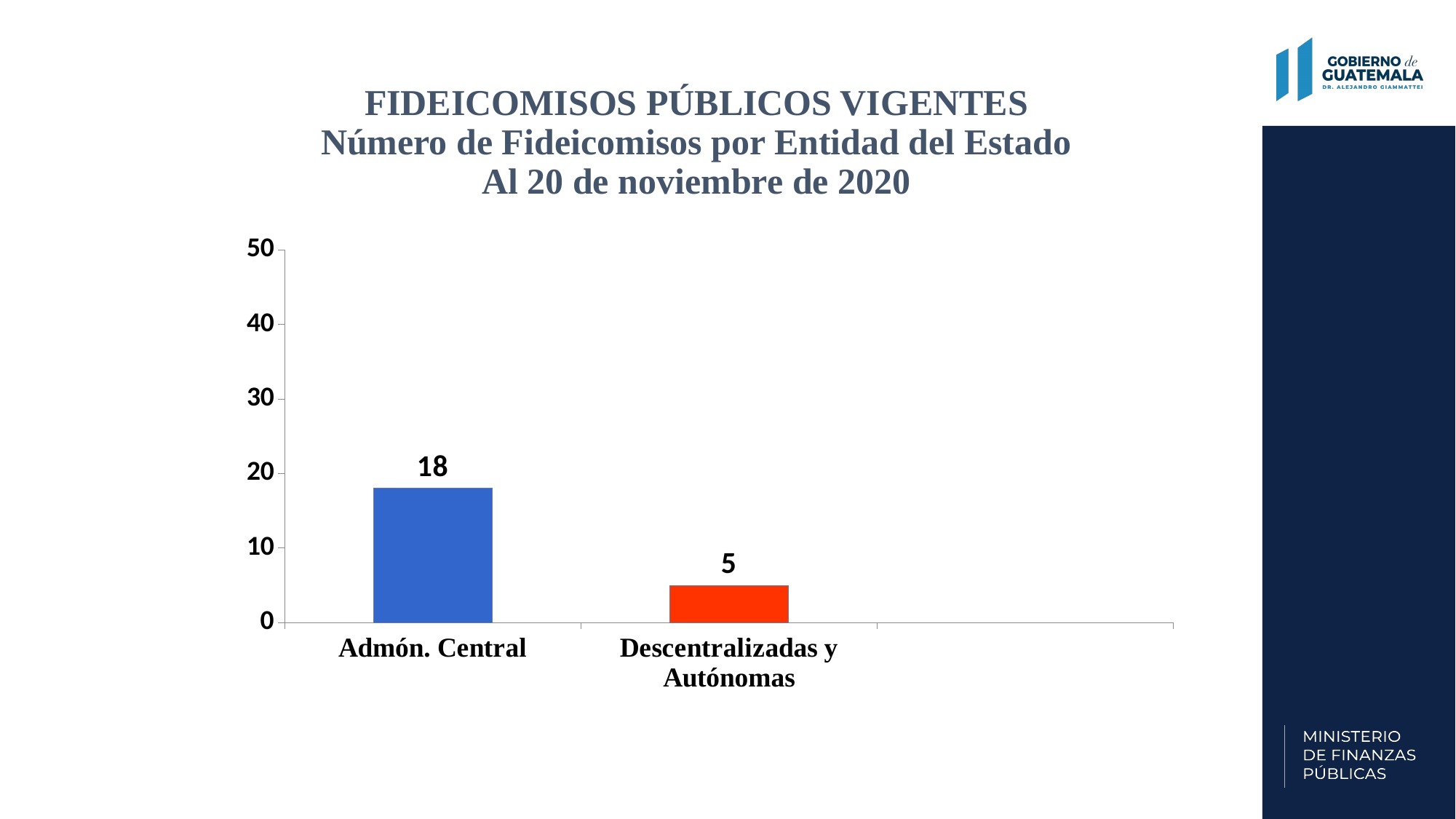
What kind of chart is shown on the slide? Bar chart What is the number of fideicomisos for Admón. Central? 18 What is the number of fideicomisos for Descentralizadas y Autónomas? 5 Is the value for Descentralizadas y Autónomas greater or less than 10? less How many categories are shown on the chart? 2 What is the total number of fideicomisos across both entities shown? 23 What is the highest value shown on the vertical axis of the chart? 50 Is the value for Admón. Central greater or less than 20? less Which entity has the lowest number of fideicomisos? Descentralizadas y Autónomas What is the difference between the number of fideicomisos for Admón. Central and Descentralizadas y Autónomas? 13 Which has more fideicomisos, Admón. Central or Descentralizadas y Autónomas? Admón. Central Which entity has the highest number of fideicomisos? Admón. Central